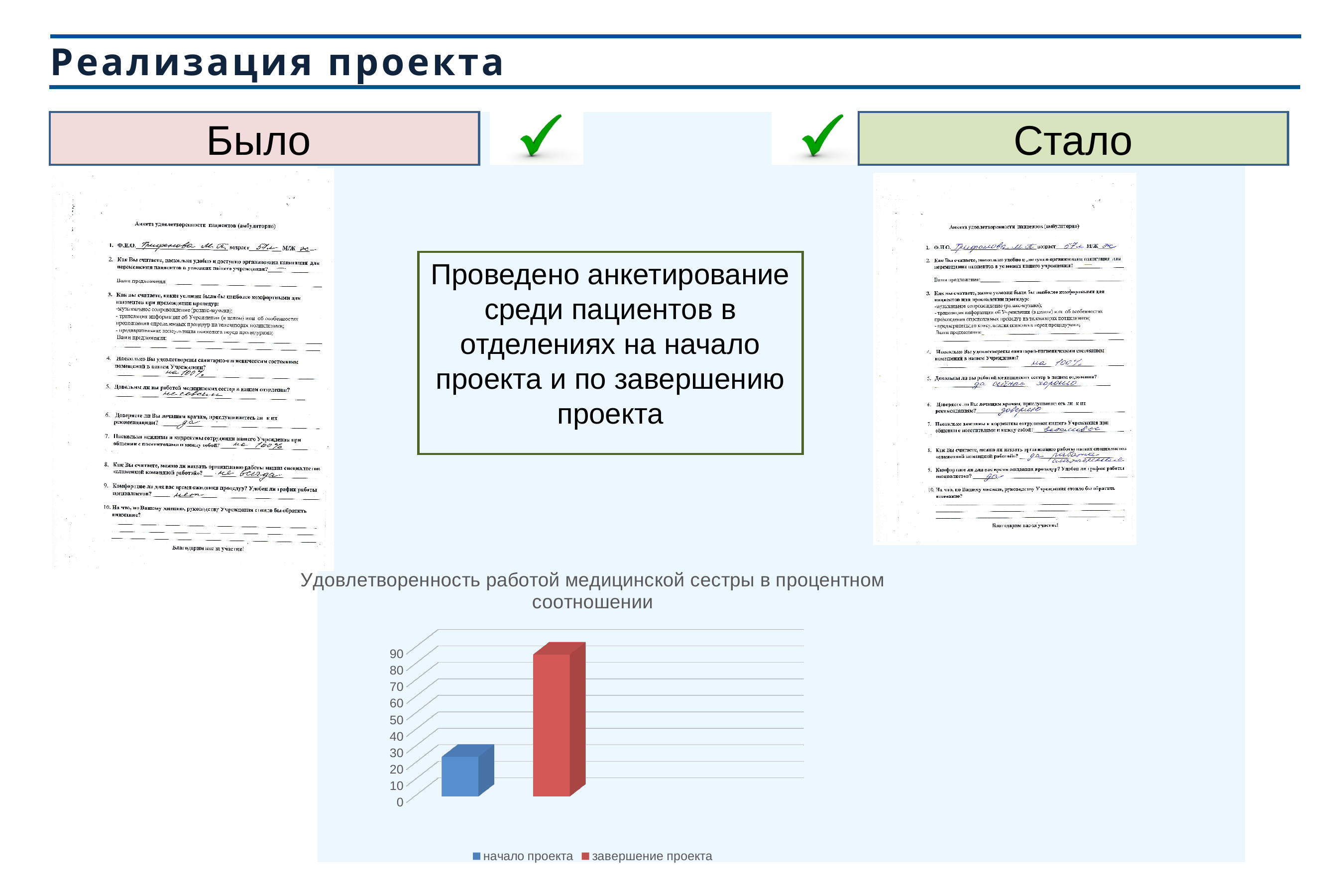
Is the value for начало проекта greater or less than 10? greater How many bars are plotted on the chart? 2 Is the value for начало проекта greater or less than 50? less Is the value for завершение проекта greater or less than 70? greater Does satisfaction rise or fall from the start of the project to its completion? rise What is the title of the chart? Удовлетворенность работой медицинской сестры в процентном соотношении Which series has the higher value: начало проекта or завершение проекта? завершение проекта How many series does the chart legend list? 2 What kind of chart is shown on the slide? bar chart What are the two series named in the chart legend? начало проекта, завершение проекта Which series shows the highest value on the chart? завершение проекта Which series shows the lowest value on the chart? начало проекта